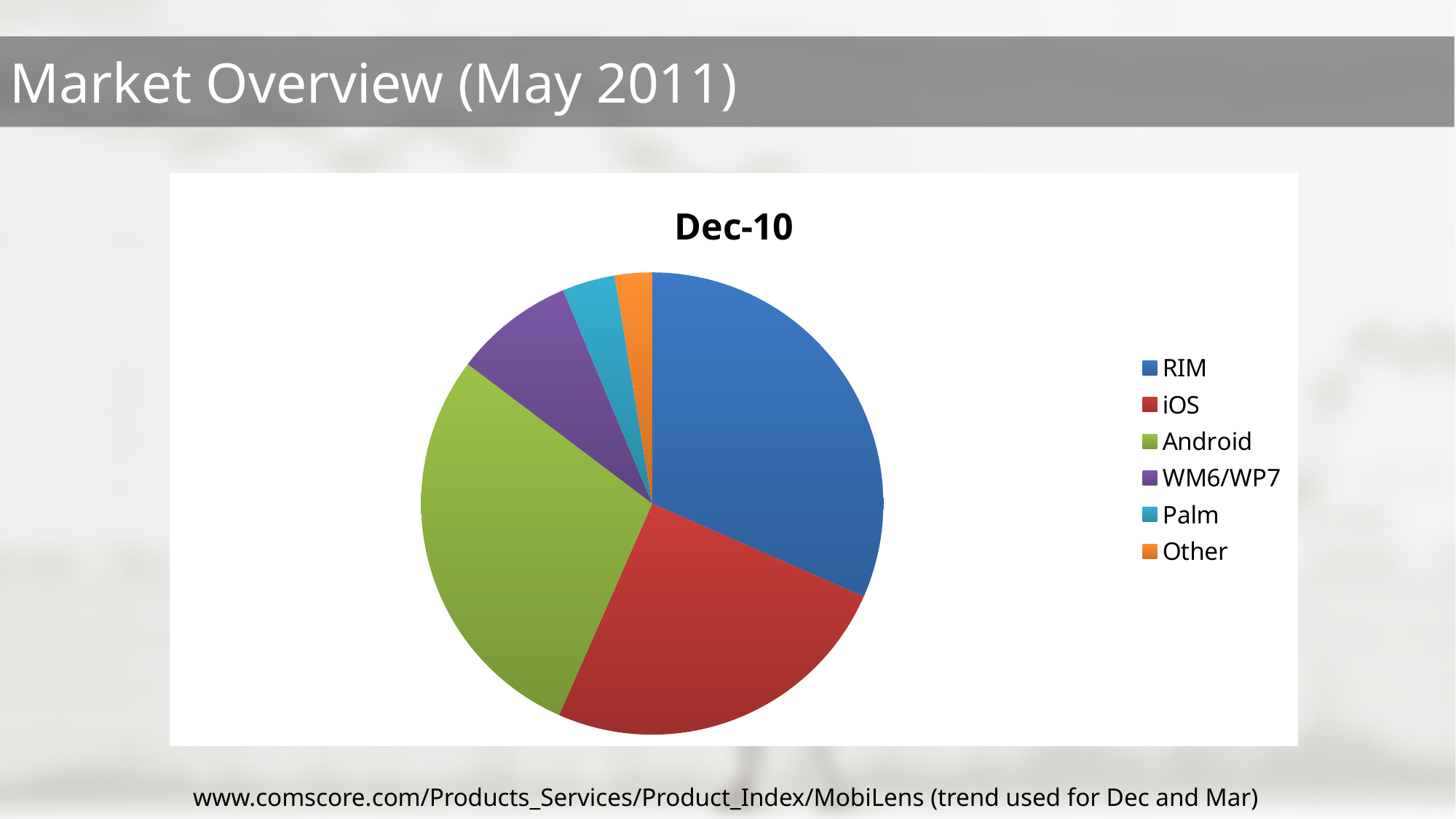
What kind of chart is shown on the slide? pie chart What is the title of the pie chart? Dec-10 How many entries does the legend of the pie chart list? 6 Which slice is larger in the pie chart, RIM or iOS? RIM How many slices does the pie chart have? 6 Which slice is larger in the pie chart, Android or iOS? Android Which slice is larger in the pie chart, iOS or WM6/WP7? iOS Which colour represents RIM in the pie chart? blue